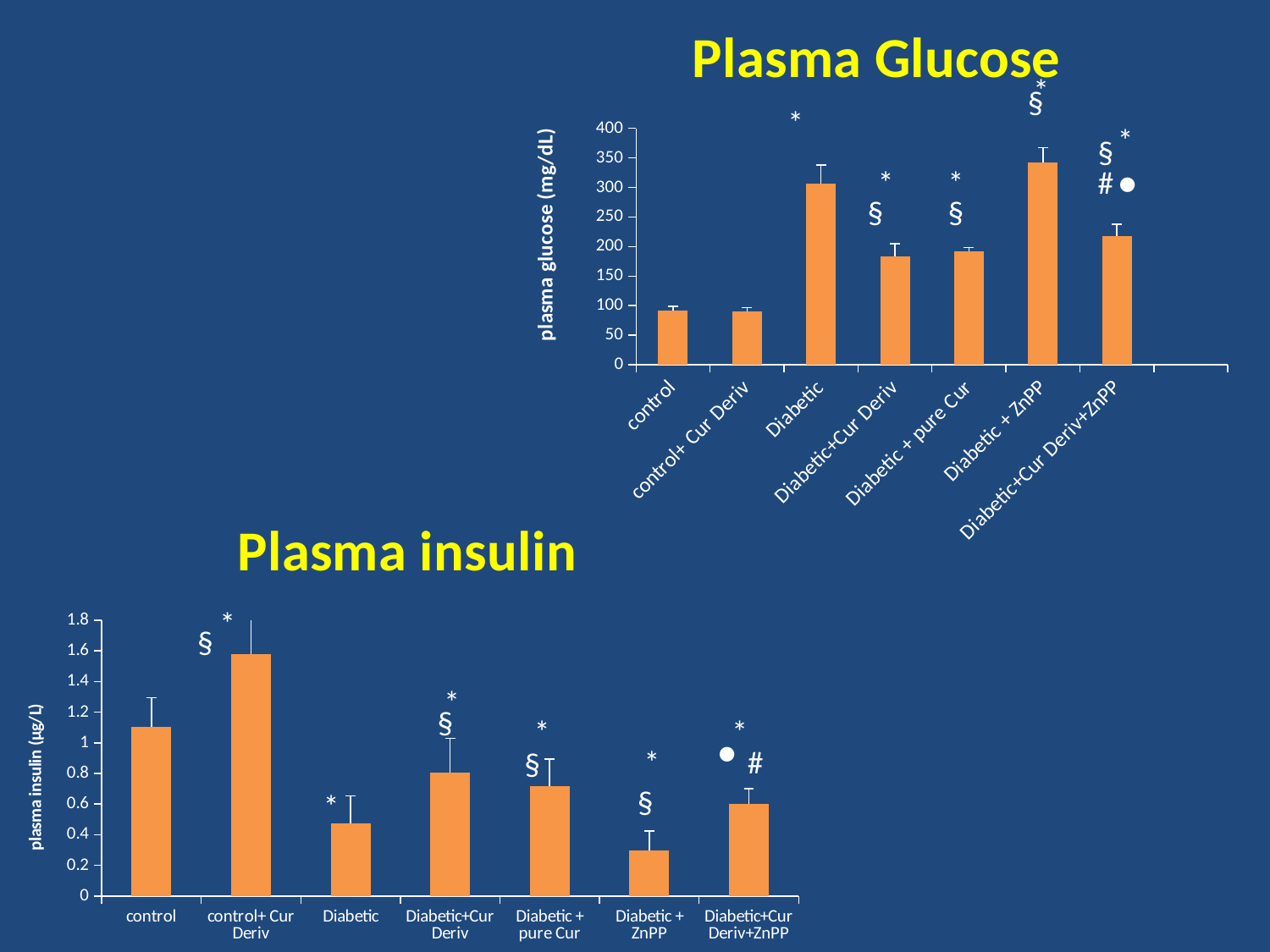
In the Plasma insulin chart, which group has the highest plasma insulin? control+ Cur Deriv In the Plasma insulin chart, which is larger, the value for control or the value for Diabetic? control What kind of chart is the Plasma insulin chart? bar chart In the Plasma insulin chart, is the value for control greater or less than 1? greater In the Plasma Glucose chart, which is larger, the value for Diabetic or the value for Diabetic+Cur Deriv? Diabetic What is the y-axis label of the Plasma Glucose chart? plasma glucose (mg/dL) In the Plasma Glucose chart, is the value for control greater or less than 150? less In the Plasma Glucose chart, is the value for Diabetic+Cur Deriv+ZnPP greater or less than 300? less In the Plasma insulin chart, which group has the lowest plasma insulin? Diabetic + ZnPP How many groups are shown on the x axis of the Plasma Glucose chart? 7 In the Plasma Glucose chart, which group has the highest plasma glucose? Diabetic + ZnPP